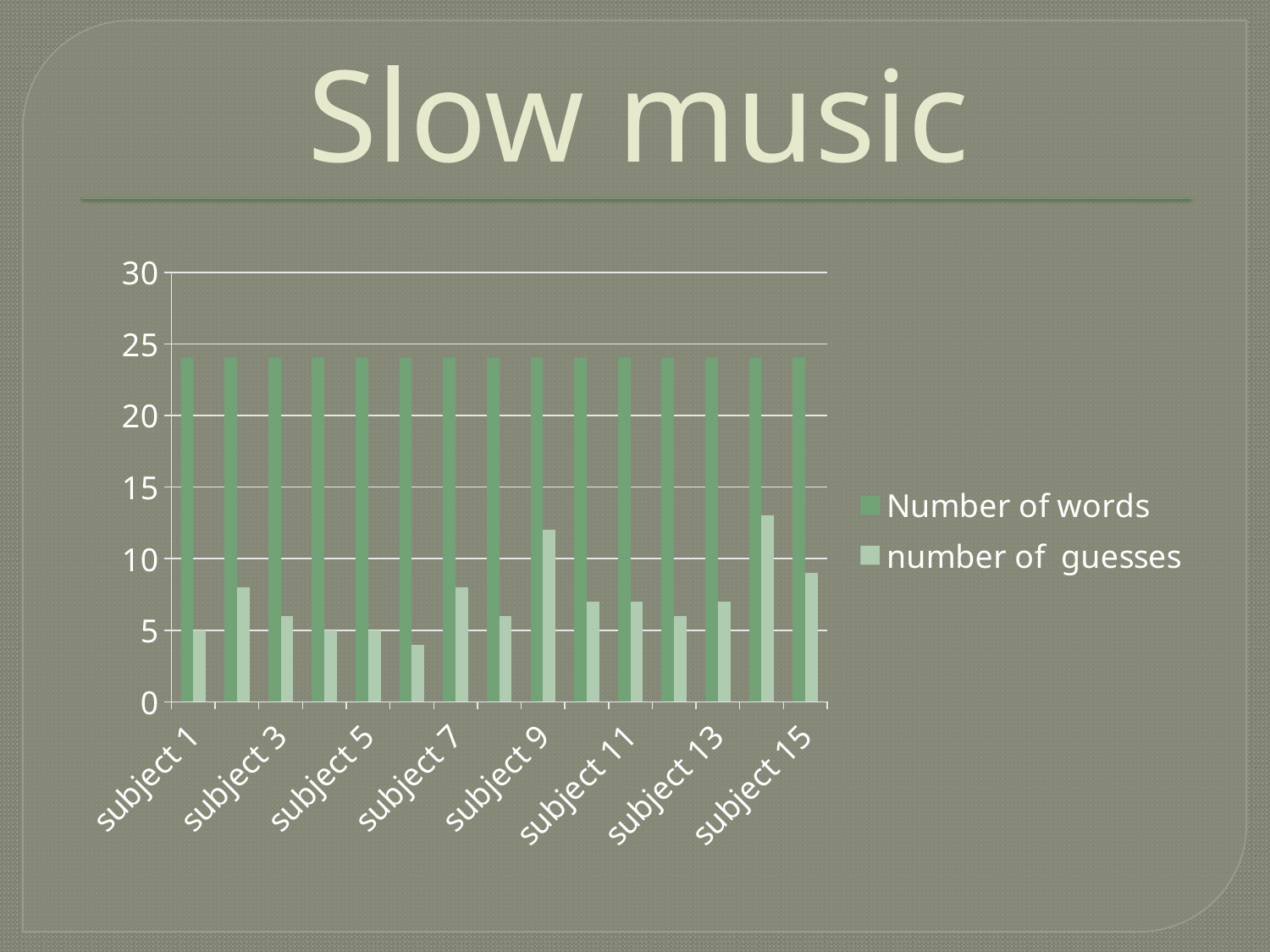
Is the value for Number of words for subject 1 greater or less than 20? greater Is the value for number of guesses for subject 2 greater or less than 10? less Is the value for number of guesses for subject 14 greater or less than 10? greater What are the two series named in the legend? Number of words; number of guesses How many subjects are shown on the x axis? 15 How many series does the legend list? 2 What is the title of the slide containing the chart? Slow music Which subject has the lowest number of guesses? subject 6 Which is larger, the number of guesses for subject 9 or for subject 2? subject 9 What kind of chart is shown on the slide? bar chart